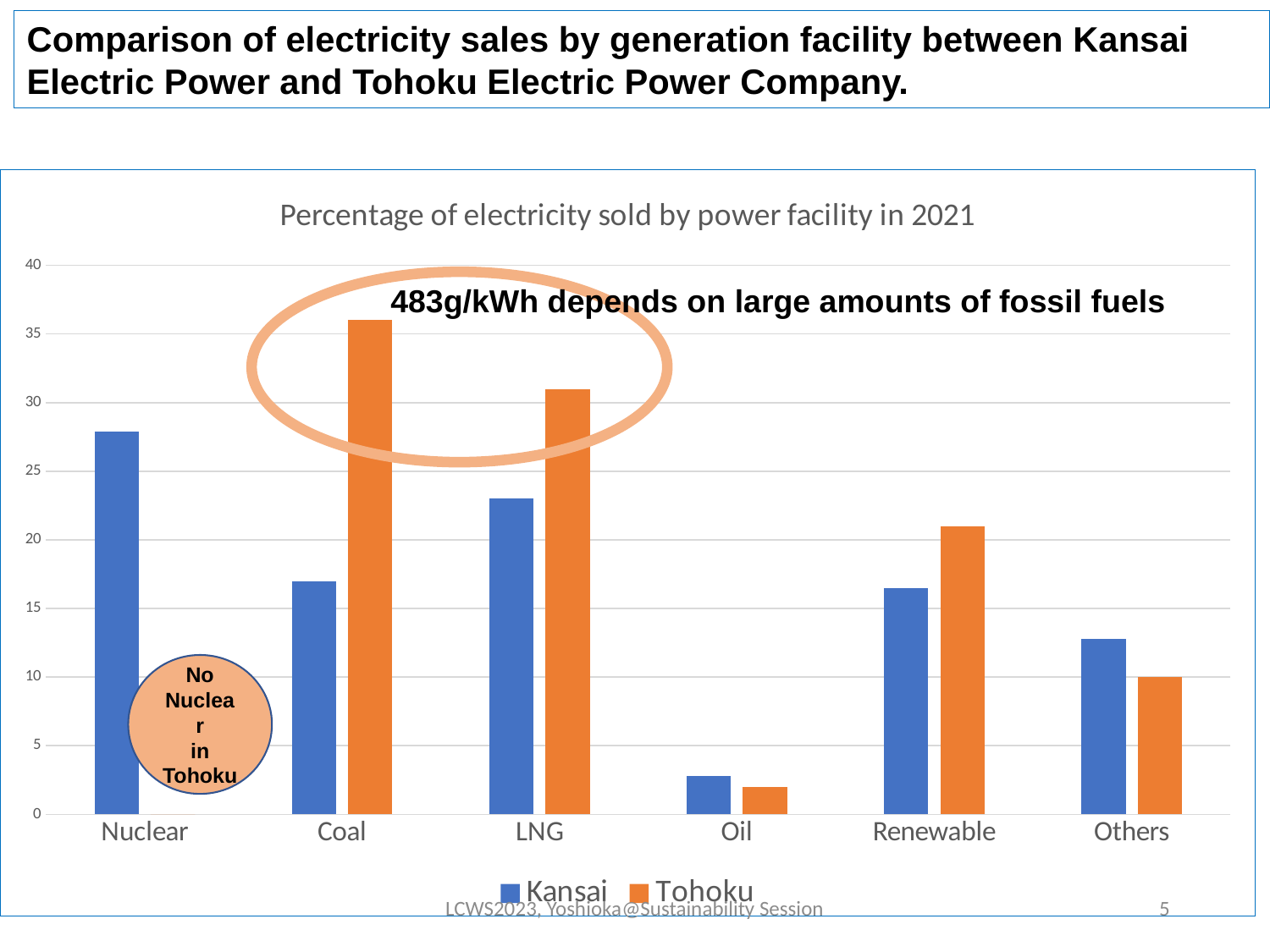
For Others, which company has the larger value, Kansai or Tohoku? Kansai How many generation facility categories are shown on the x axis? 6 Is the value for Kansai Oil greater or less than 5? less Is the value for Tohoku Coal greater or less than 30? greater Which category has the lowest value for Kansai? Oil Is the value for Kansai Nuclear greater or less than 25? greater Which category has the highest value for Tohoku? Coal What is the title of the chart? Percentage of electricity sold by power facility in 2021 Which category has the highest value for Kansai? Nuclear What kind of chart is shown on the slide? Bar chart For Coal, which company has the larger value, Kansai or Tohoku? Tohoku How many series does the legend list? 2